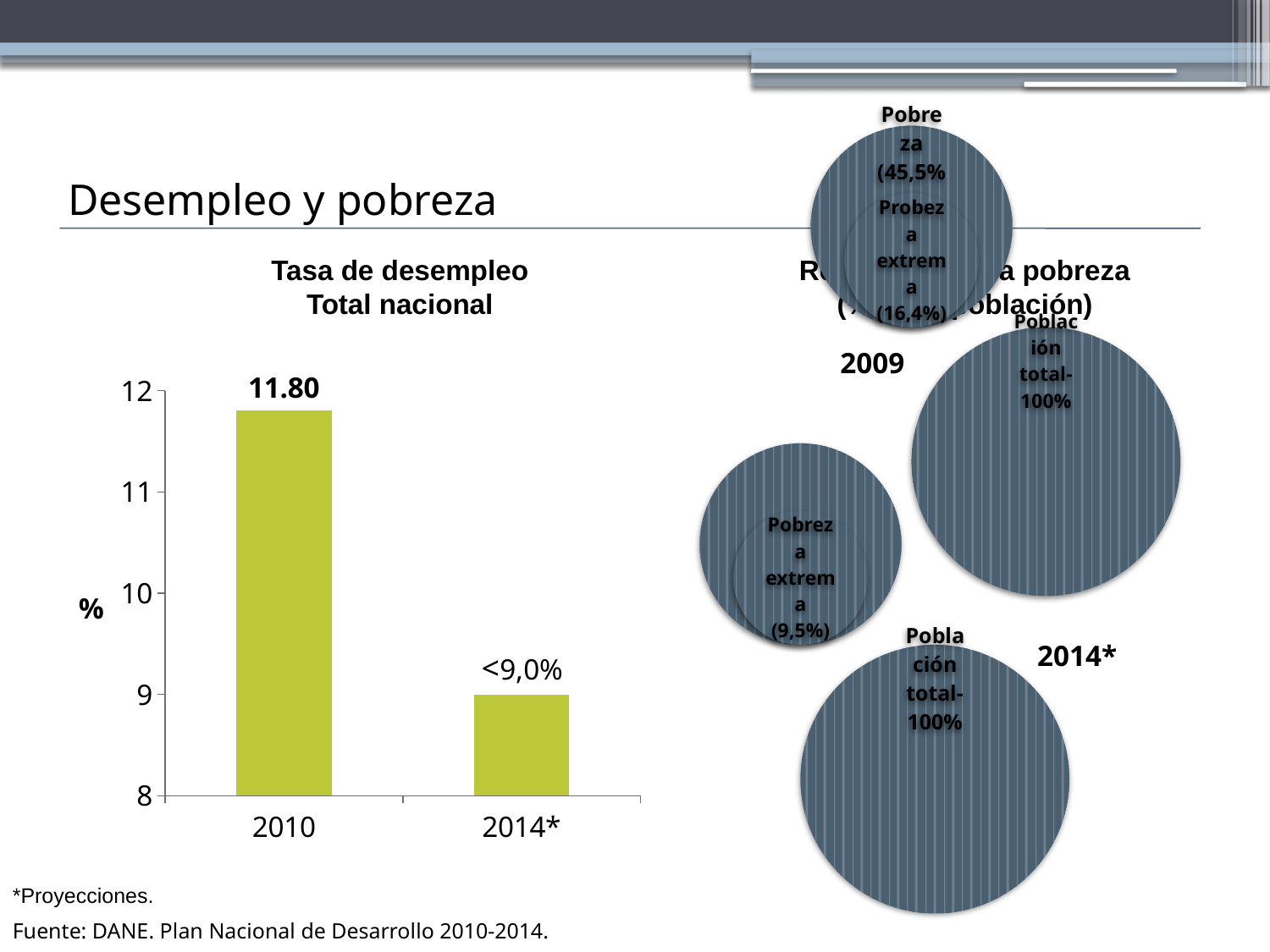
What kind of chart is 'Tasa de desempleo Total nacional'? Bar chart In the 'Tasa de desempleo Total nacional' bar chart, which is larger, the value for 2010 or for 2014*? 2010 In the 'Tasa de desempleo Total nacional' bar chart, which year has the highest unemployment rate? 2010 In the poverty circle diagram on the right, what percentage is shown for 'Pobreza extrema' in 2014*? 9,5% In the 'Tasa de desempleo Total nacional' bar chart, do the values rise or fall from 2010 to 2014*? Fall How many categories are shown on the x axis of the 'Tasa de desempleo Total nacional' chart? 2 In the 'Tasa de desempleo Total nacional' bar chart, is the value for 2010 greater or less than 11? greater In the 'Tasa de desempleo Total nacional' bar chart, is the value for 2014* greater or less than 10? less What is the label on the y axis of the 'Tasa de desempleo Total nacional' chart? % In the 'Tasa de desempleo Total nacional' bar chart, which year has the lowest unemployment rate? 2014* In the 'Tasa de desempleo Total nacional' bar chart, what is the value for 2010? 11.80 In the 'Tasa de desempleo Total nacional' bar chart, what label is shown for 2014*? <9,0%